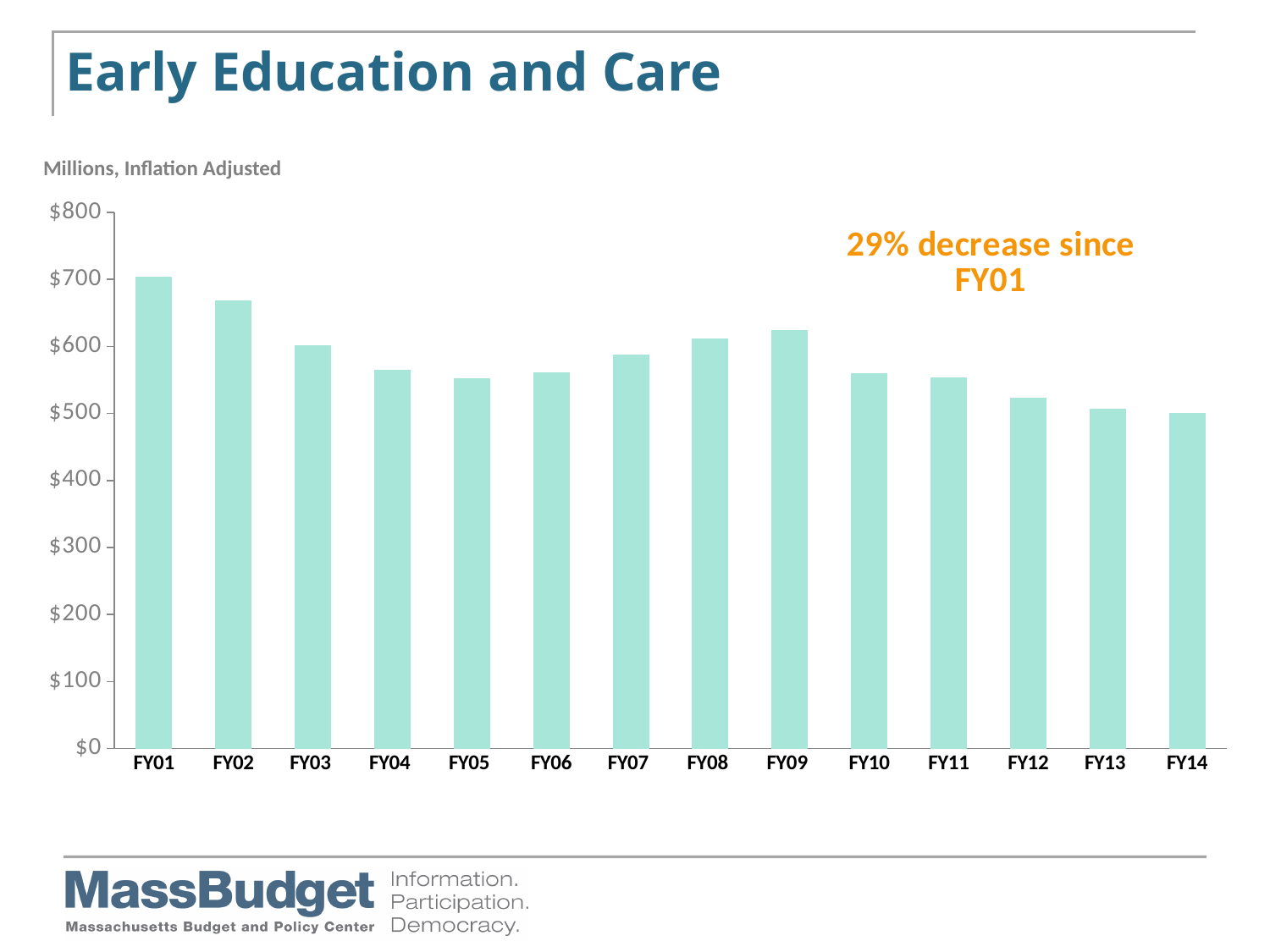
Which is larger, the value for FY09 or the value for FY10? FY09 Overall, do the values rise or fall from FY01 to FY14? fall What percentage decrease since FY01 does the annotation on the chart state? 29% decrease since FY01 Is the value for FY01 greater or less than $600? greater Is the value for FY05 greater or less than $600? less How many fiscal years are plotted on the chart? 14 Is the value for FY14 greater or less than $600? less Which fiscal year has the highest value on the chart? FY01 What kind of chart is shown on the slide? Bar chart Which is larger, the value for FY01 or the value for FY14? FY01 What unit label is shown above the chart's vertical axis? Millions, Inflation Adjusted